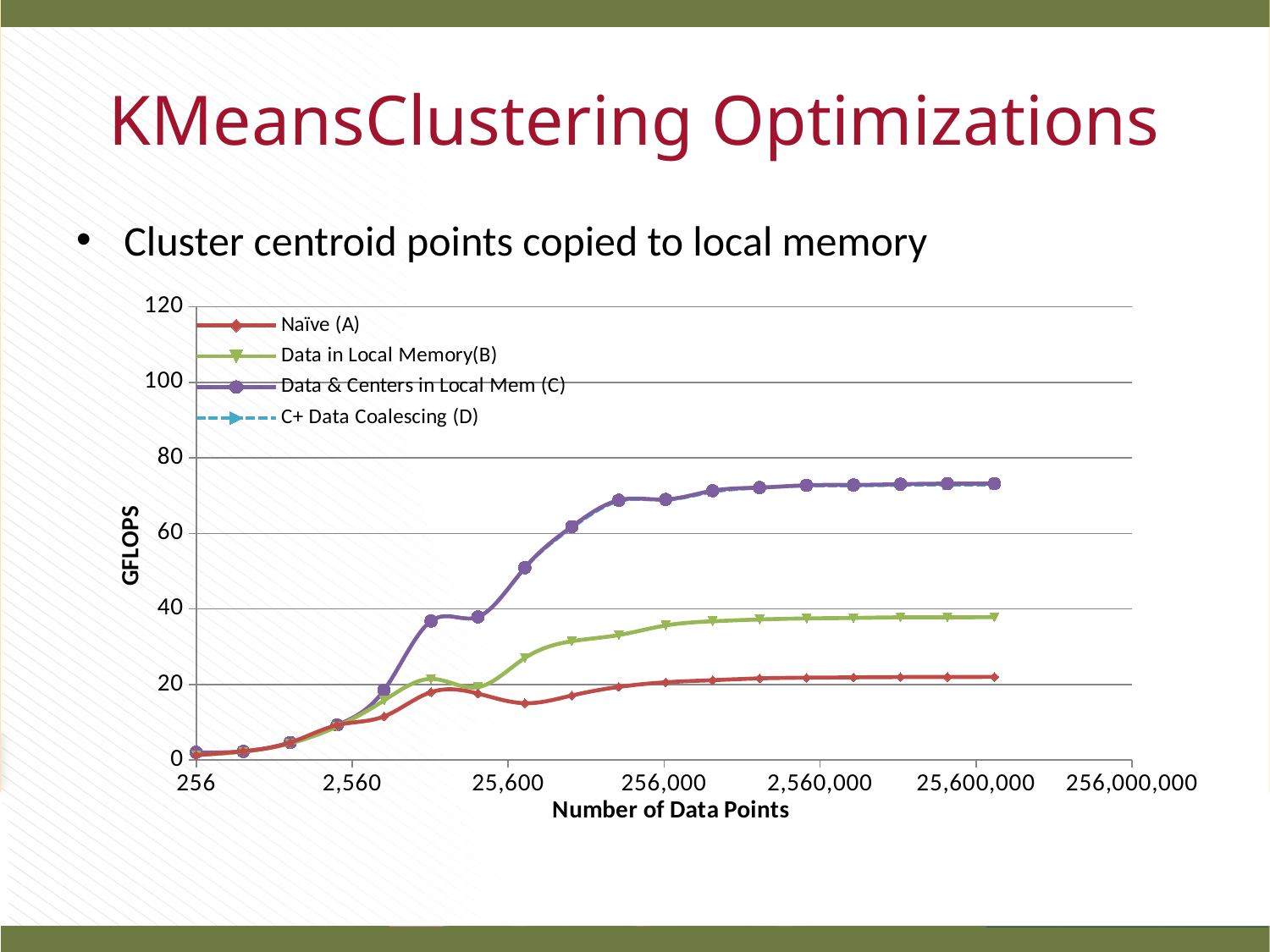
What is the label of the y axis of the chart? GFLOPS At 25,600 data points, which is larger: the value for Data & Centers in Local Mem (C) or the value for Naïve (A)? Data & Centers in Local Mem (C) Is the value for Naïve (A) at 25,600,000 data points greater or less than 40? less Do the GFLOPS values for Data & Centers in Local Mem (C) generally rise or fall as the number of data points increases? rise What is the label of the x axis of the chart? Number of Data Points Is the value for Data & Centers in Local Mem (C) at 256,000 data points greater or less than 60? greater At 256,000 data points, which is larger: the value for Naïve (A) or the value for Data in Local Memory(B)? Data in Local Memory(B) How many tick labels are shown on the x axis of the chart? 7 How many series does the chart legend list? 4 Is the value for Data in Local Memory(B) at 25,600,000 data points greater or less than 20? greater What kind of chart is shown on the slide? line chart